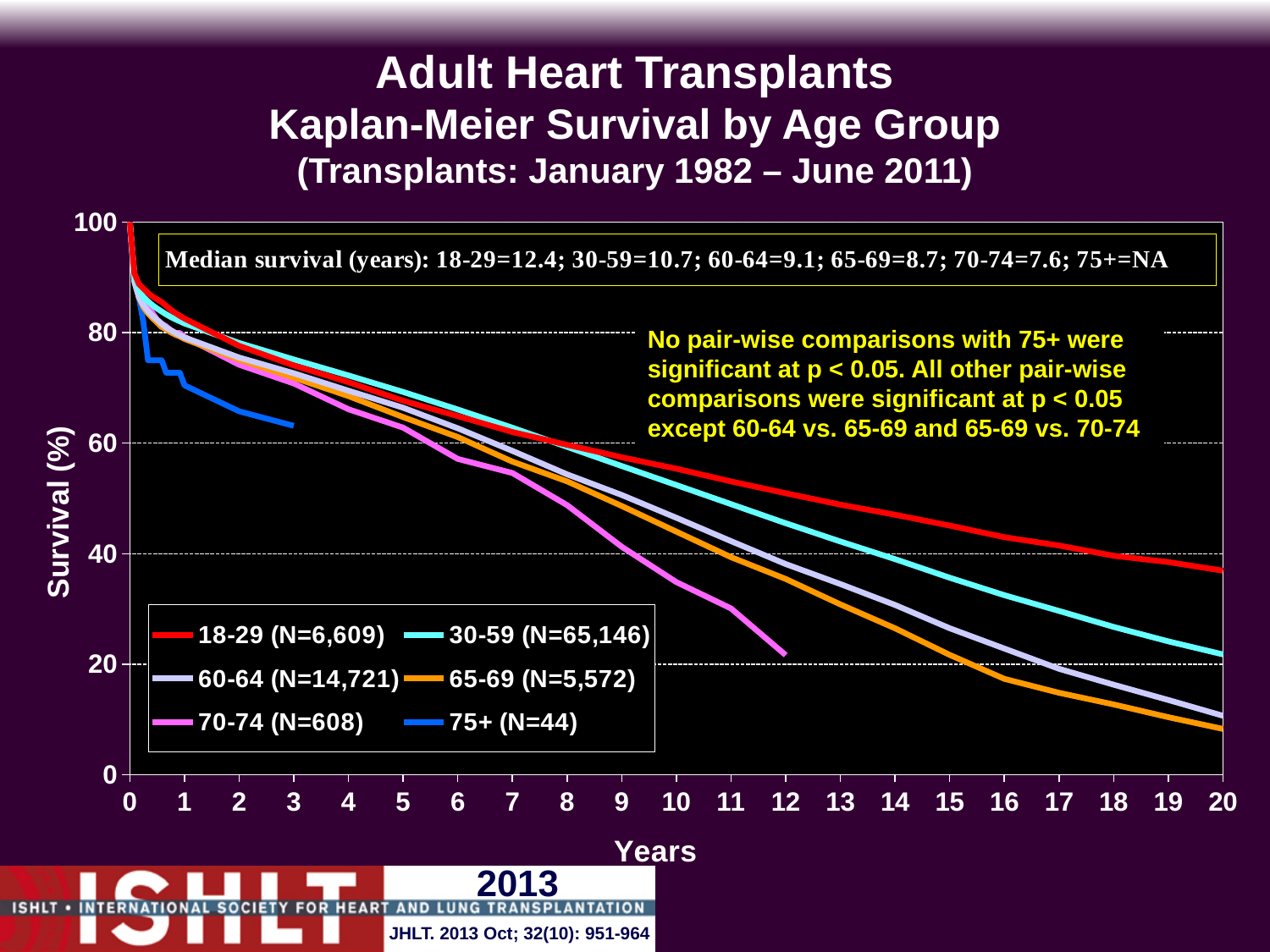
Is the survival value for the 65-69 group at 20 years greater or less than 20? less What kind of chart is shown on the slide? Line chart Do the survival curves rise or fall as years increase? Fall What is the median survival in years for the 70-74 age group? 7.6 How many age-group series does the legend list? 6 Among the age groups with a numeric median survival, which has the lowest? 70-74 Which age group has a larger N, 30-59 or 60-64? 30-59 Which age group has the highest median survival? 18-29 Is the survival value for the 18-29 group at 20 years greater or less than 40? less What is the median survival listed for the 75+ age group? NA What is the difference in median survival (years) between the 18-29 and 30-59 age groups? 1.7 What is the median survival in years for the 18-29 age group? 12.4